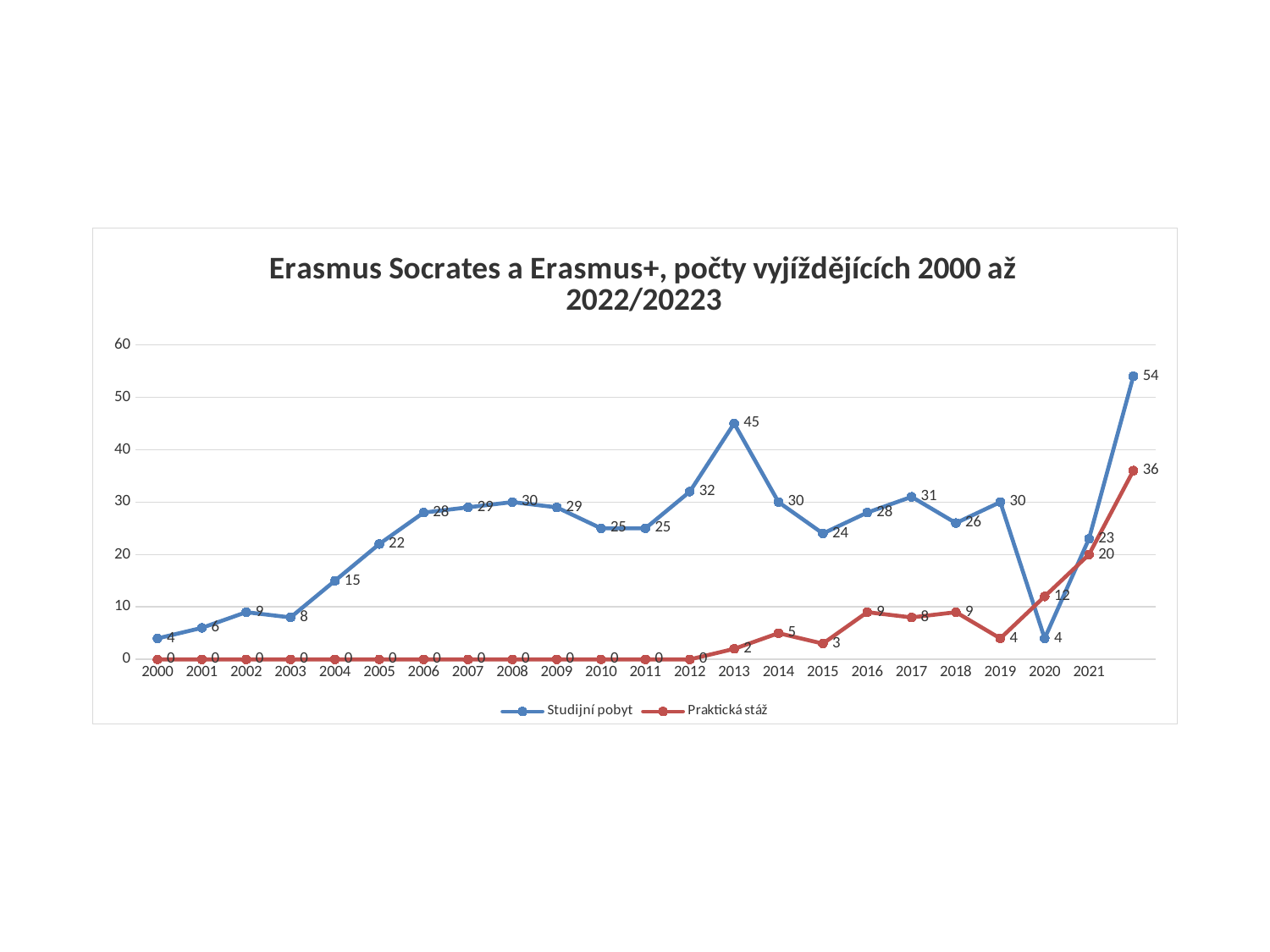
In which labeled year between 2000 and 2021 is Studijní pobyt highest? 2013 Which series has the larger value in 2020, Studijní pobyt or Praktická stáž? Praktická stáž What is the value for Praktická stáž in 2020? 12 What is the difference between Studijní pobyt and Praktická stáž in 2021? 3 What type of chart is shown on the slide? line chart Does the Praktická stáž series rise or fall from 2019 to 2021? rise How many series does the legend list? 2 What is the value for Studijní pobyt in 2013? 45 What is the value for Studijní pobyt in 2004? 15 What is the title of the chart? Erasmus Socrates a Erasmus+, počty vyjíždějících 2000 až 2022/20223 What is the difference between the Studijní pobyt values in 2013 and 2014? 15 What is the value for Praktická stáž in 2016? 9